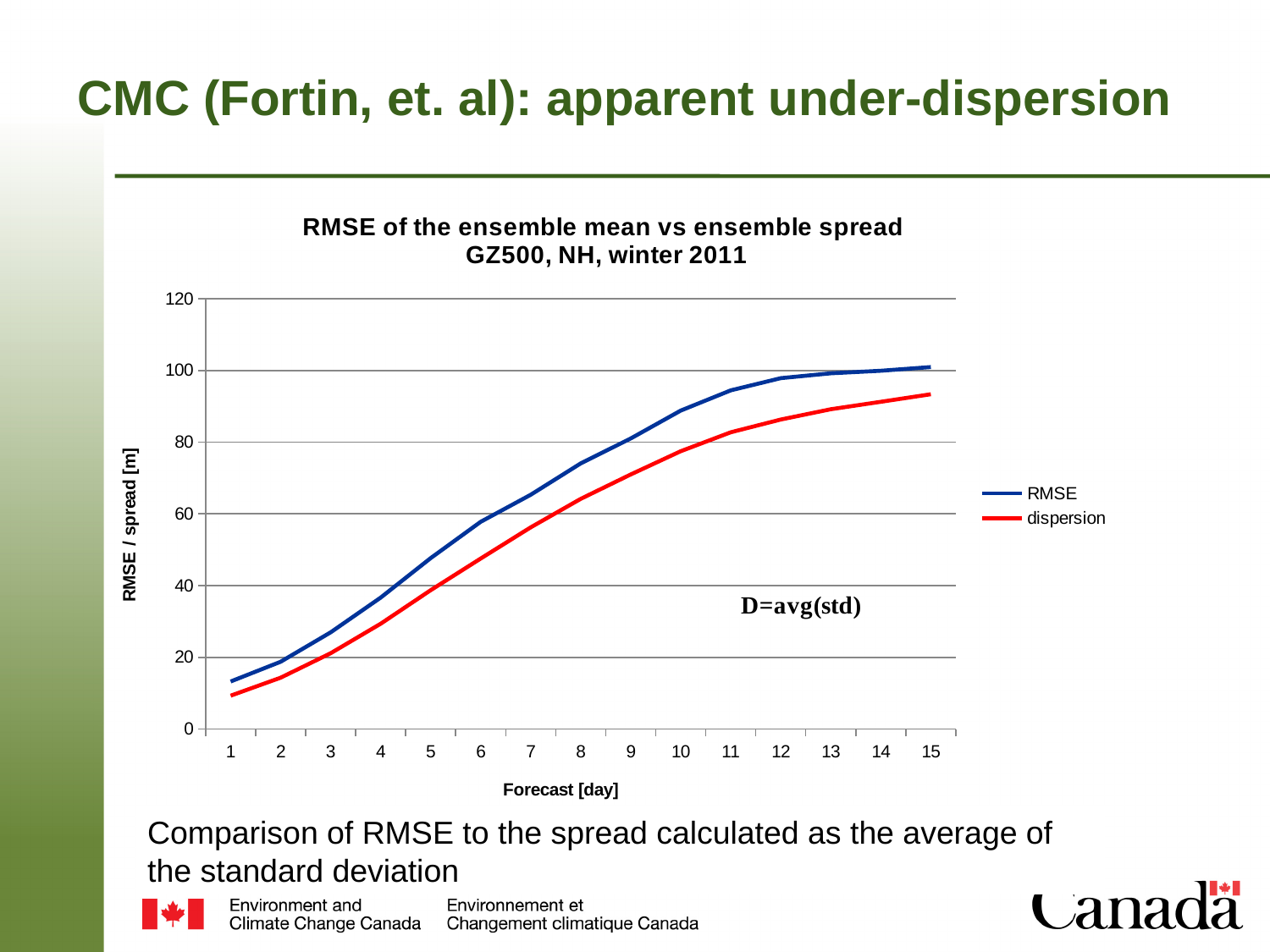
Is the dispersion value at forecast day 15 greater or less than 100? less Is the dispersion value at forecast day 4 greater or less than 40? less How many forecast days are plotted along the x axis? 15 Is the dispersion value at forecast day 1 greater or less than 20? less What is the label of the y axis? RMSE / spread [m] Do the RMSE values rise or fall as the forecast day increases? rise What kind of chart is shown on the slide? line chart How many series does the legend list? 2 Which series is higher at forecast day 10, RMSE or dispersion? RMSE What colour is the dispersion line? red